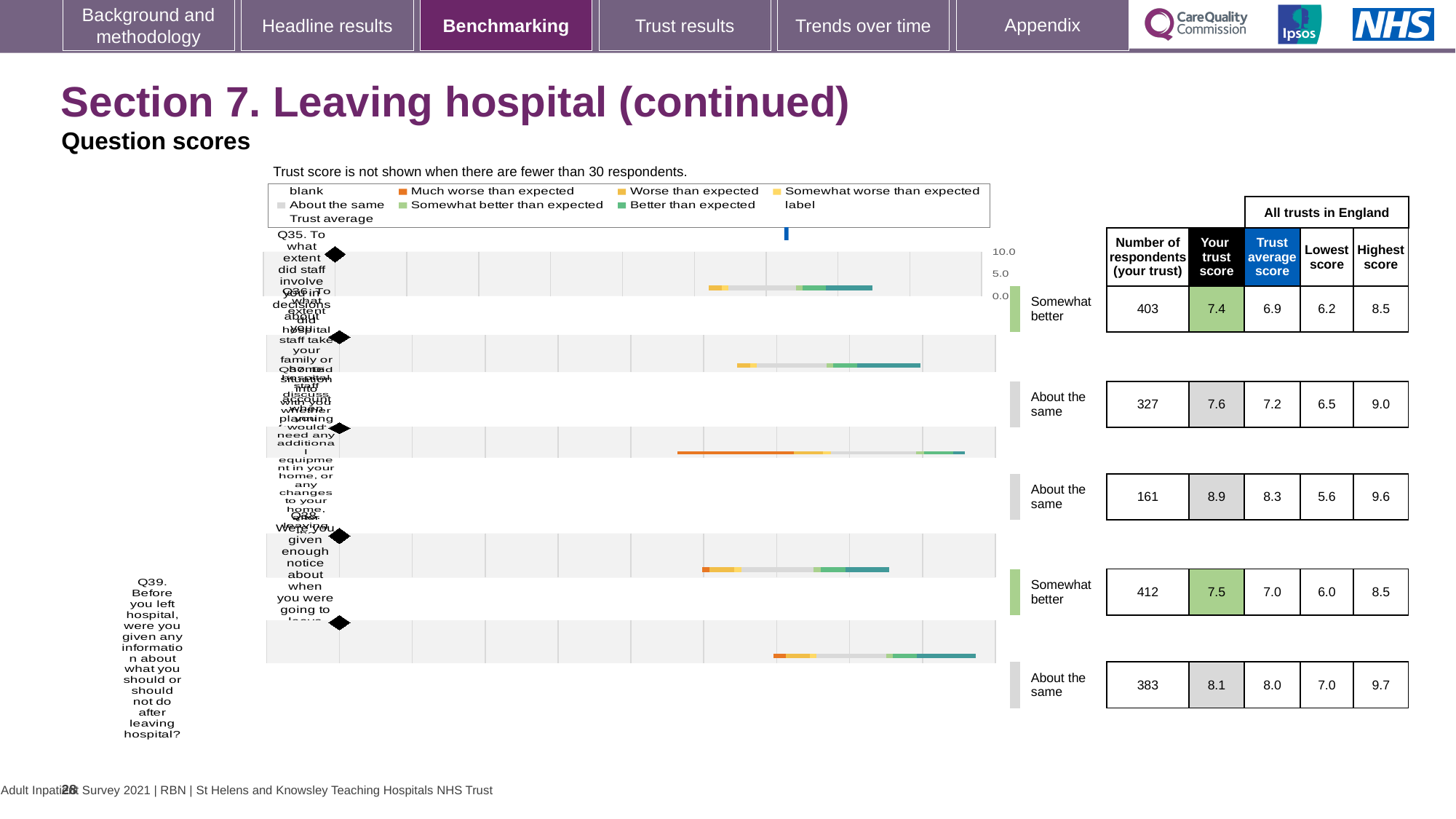
For Q35 (the first row), what is the difference between 'Your trust score' and the 'Trust average score'? 0.5 What kind of chart is used to show the question scores? Bar chart What is the highest score across all trusts in England for Q39 (the last question row)? 9.7 What is the 'Your trust score' value for Q35 (the first question row)? 7.4 What colour does the legend use for 'Much worse than expected'? Orange Which question row has the highest 'Your trust score'? Q37 (the third row), 8.9 How many question rows are shown in the chart? 5 What benchmark category is shown for Q35 (the first row)? Somewhat better Which question row has the lowest number of respondents? Q37 (the third row), 161 For Q39 (the last row), which is larger: 'Your trust score' or the 'Trust average score'? Your trust score (8.1) What is the lowest score across all trusts in England for the fourth question row (Q38)? 6.0 How many respondents from your trust answered Q39 (the last question row)? 383